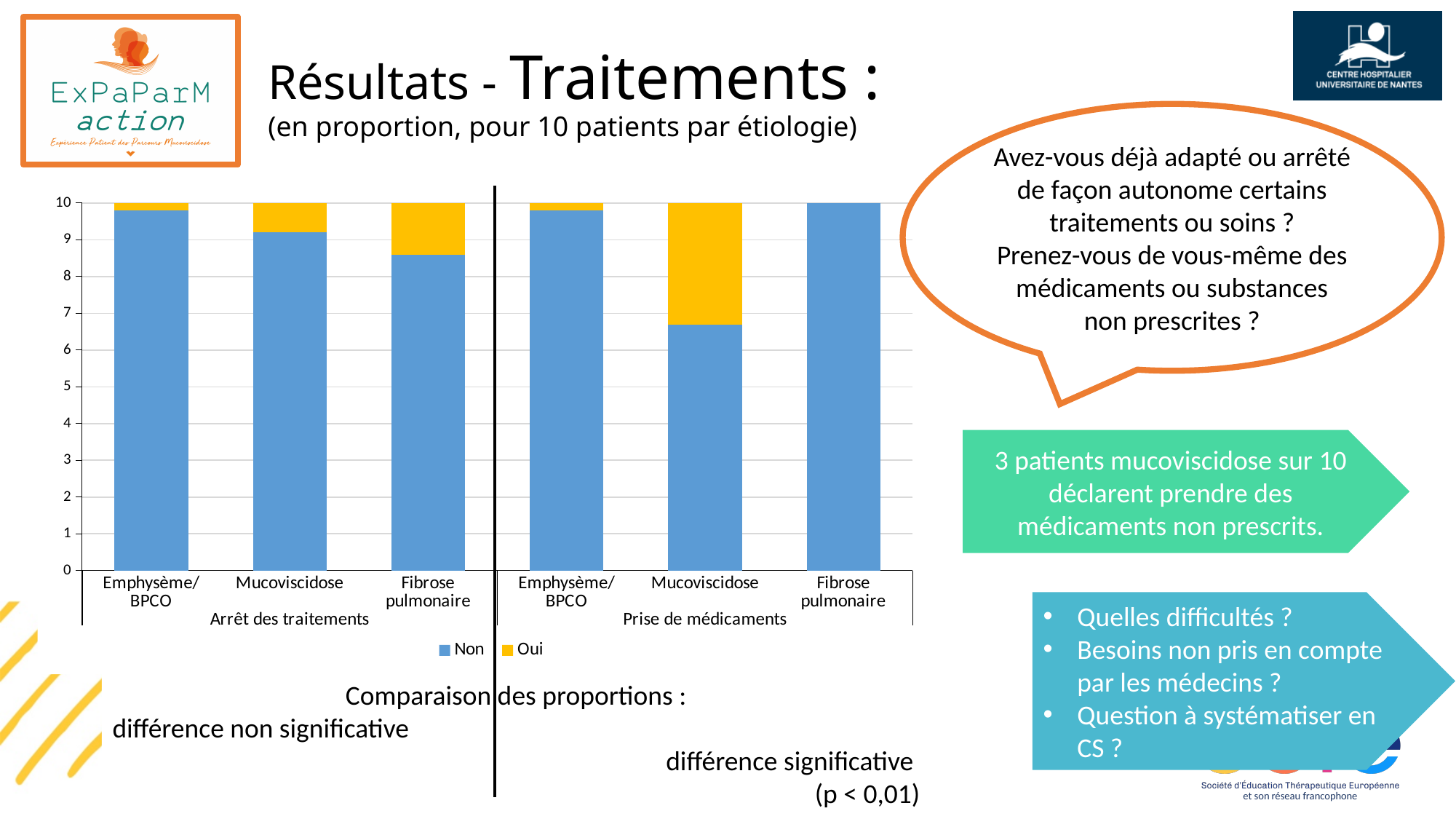
Is the 'Non' value for Mucoviscidose in the 'Prise de médicaments' group greater or less than 7? less What are the two series named in the chart legend? Non and Oui Is the 'Non' value for Fibrose pulmonaire in the 'Arrêt des traitements' group greater or less than 8? greater What kind of chart is shown on the slide? Stacked bar chart In the 'Arrêt des traitements' group, which category has the smallest 'Non' segment? Fibrose pulmonaire In the 'Arrêt des traitements' group, which category has the largest 'Oui' segment? Fibrose pulmonaire How many bars are plotted in the chart in total? 6 What is the total height of the stacked bar for Mucoviscidose in the 'Prise de médicaments' group? 10 In the 'Prise de médicaments' group, which category has the largest 'Oui' segment? Mucoviscidose How many series does the chart legend list? 2 Which is larger: the 'Non' value for Mucoviscidose in 'Arrêt des traitements' or in 'Prise de médicaments'? Arrêt des traitements What is the value of 'Non' for Fibrose pulmonaire in the 'Prise de médicaments' group? 10